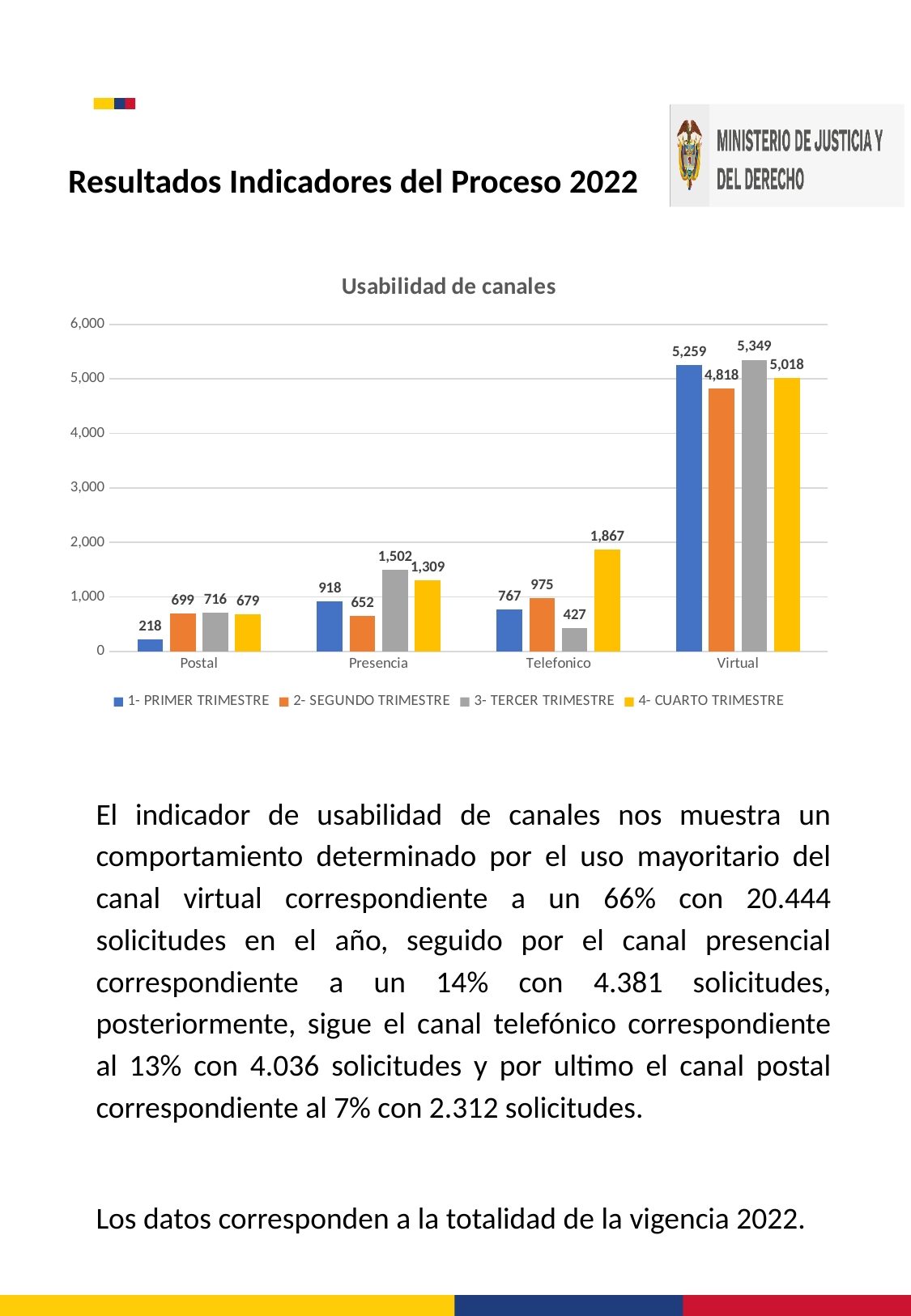
What is the value for Virtual in 3- TERCER TRIMESTRE? 5,349 Which category has the highest value in 2- SEGUNDO TRIMESTRE? Virtual What type of chart is shown on the slide? bar chart What is the difference between the 3- TERCER TRIMESTRE and 2- SEGUNDO TRIMESTRE values for Presencia? 850 Which series has the lowest value for Telefonico? 3- TERCER TRIMESTRE Which is larger for Virtual: the 1- PRIMER TRIMESTRE value or the 4- CUARTO TRIMESTRE value? 1- PRIMER TRIMESTRE How many series does the legend list? 4 What is the title of the chart? Usabilidad de canales How many categories are shown on the x axis? 4 What is the value for Postal in 1- PRIMER TRIMESTRE? 218 What is the value for Telefonico in 4- CUARTO TRIMESTRE? 1,867 Is the value for Presencia in 4- CUARTO TRIMESTRE greater or less than 1,000? greater